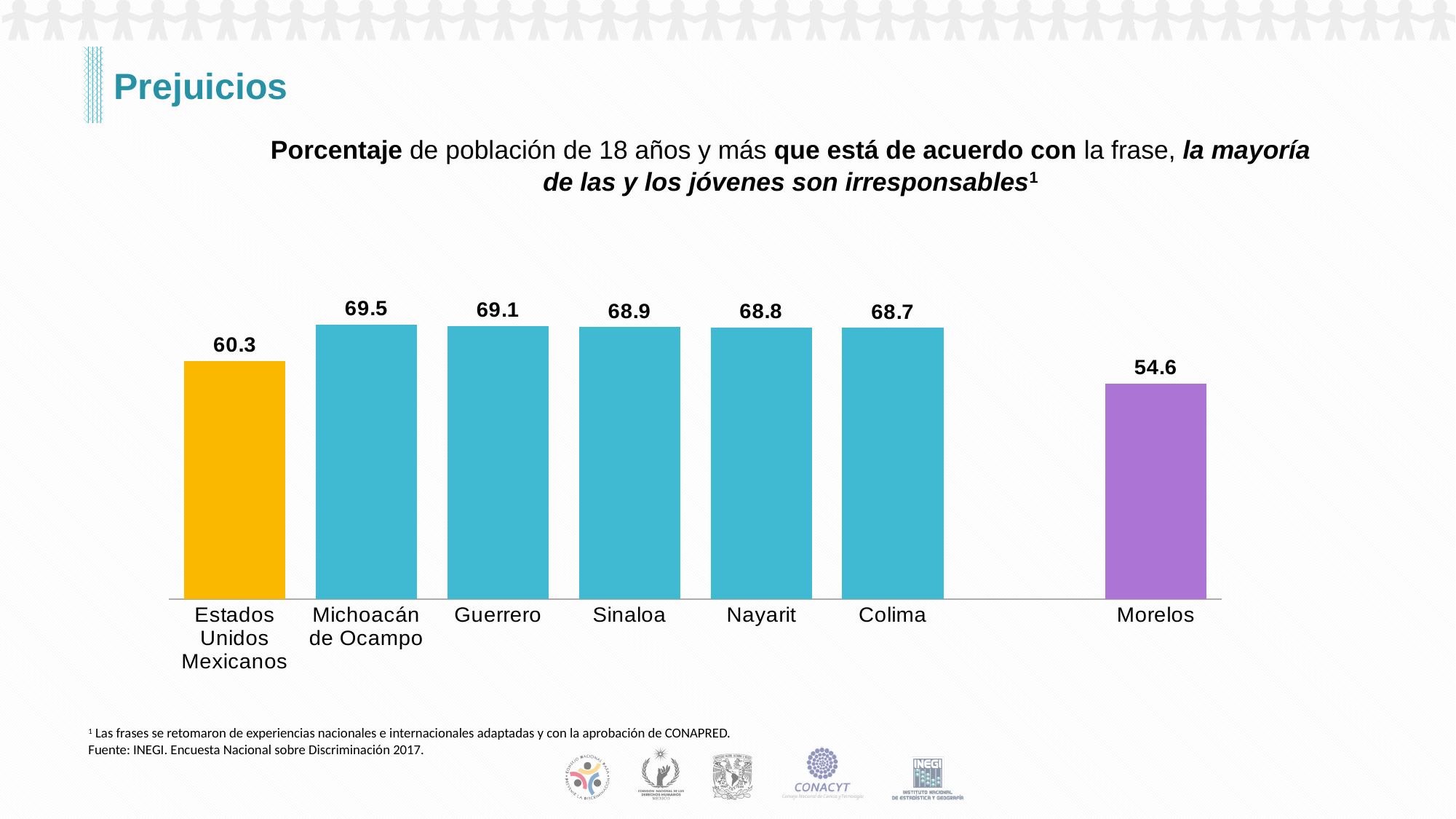
What is the value for Morelos? 54.6 What is the value for Sinaloa? 68.9 What kind of chart is shown on the slide? Bar chart Which category has the lowest value? Morelos What is the value for Estados Unidos Mexicanos? 60.3 Which is larger, the value for Guerrero or the value for Estados Unidos Mexicanos? Guerrero What is the difference between the values for Michoacán de Ocampo and Morelos? 14.9 How many categories are shown in the chart? 7 Which category has the highest value? Michoacán de Ocampo What is the difference between the values for Estados Unidos Mexicanos and Morelos? 5.7 What colour is the bar for Morelos? Purple What is the value for Michoacán de Ocampo? 69.5